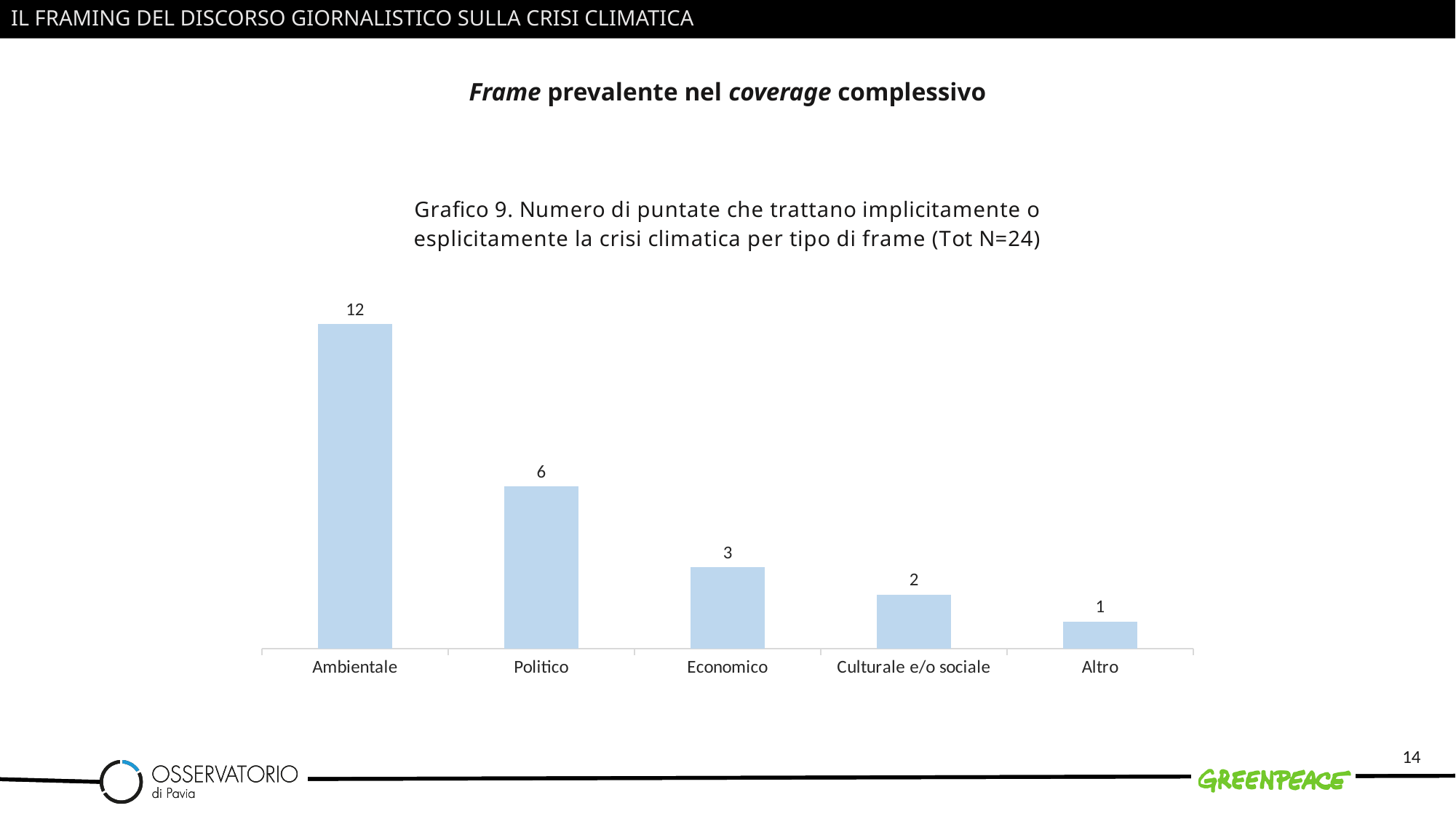
What is the value for Culturale e/o sociale? 2 What is the difference between the values for Ambientale and Politico? 6 What is the value for Economico? 3 What is the value for Politico? 6 Which category has the lowest value? Altro What is the value for Ambientale? 12 How many categories are shown on the x axis? 5 Which category has the highest value? Ambientale What kind of chart is shown on the slide? Bar chart Which is larger, the value for Economico or the value for Culturale e/o sociale? Economico What is the value for Altro? 1 Do the values rise or fall from left to right along the x axis? Fall